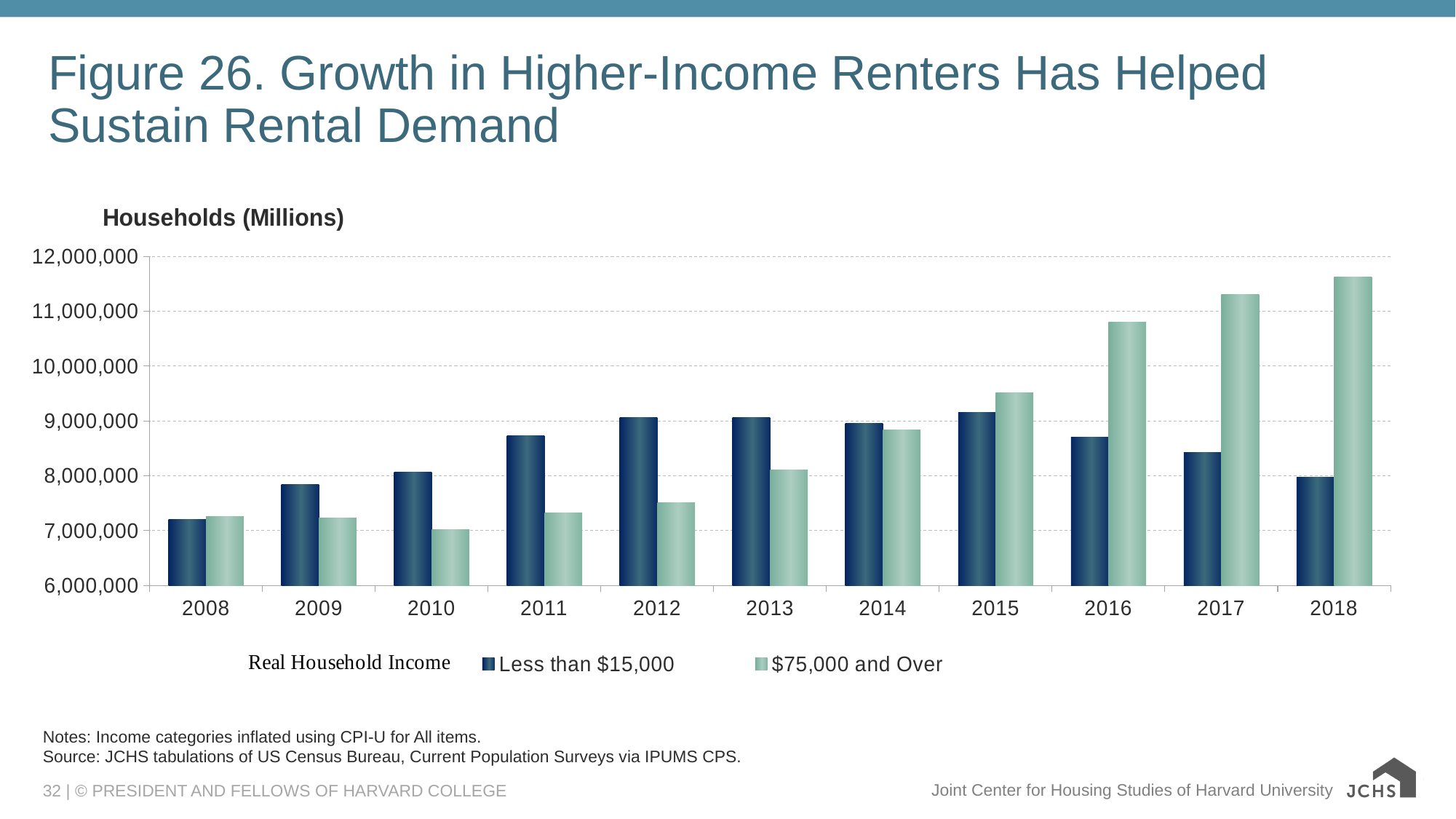
Do the values for $75,000 and Over rise or fall from 2010 to 2018? rise In which year is the value for $75,000 and Over highest? 2018 In which year is the value for $75,000 and Over lowest? 2010 In 2012, which series has the larger value, Less than $15,000 or $75,000 and Over? Less than $15,000 Is the value for Less than $15,000 in 2011 greater or less than 8,000,000? greater How many series does the legend list? 2 In which year is the value for Less than $15,000 lowest? 2008 What kind of chart is shown on the slide? bar chart Is the value for $75,000 and Over in 2017 greater or less than 11,000,000? greater In 2018, which series has the larger value, Less than $15,000 or $75,000 and Over? $75,000 and Over How many years are shown on the x axis? 11 Is the value for $75,000 and Over in 2016 greater or less than 10,000,000? greater